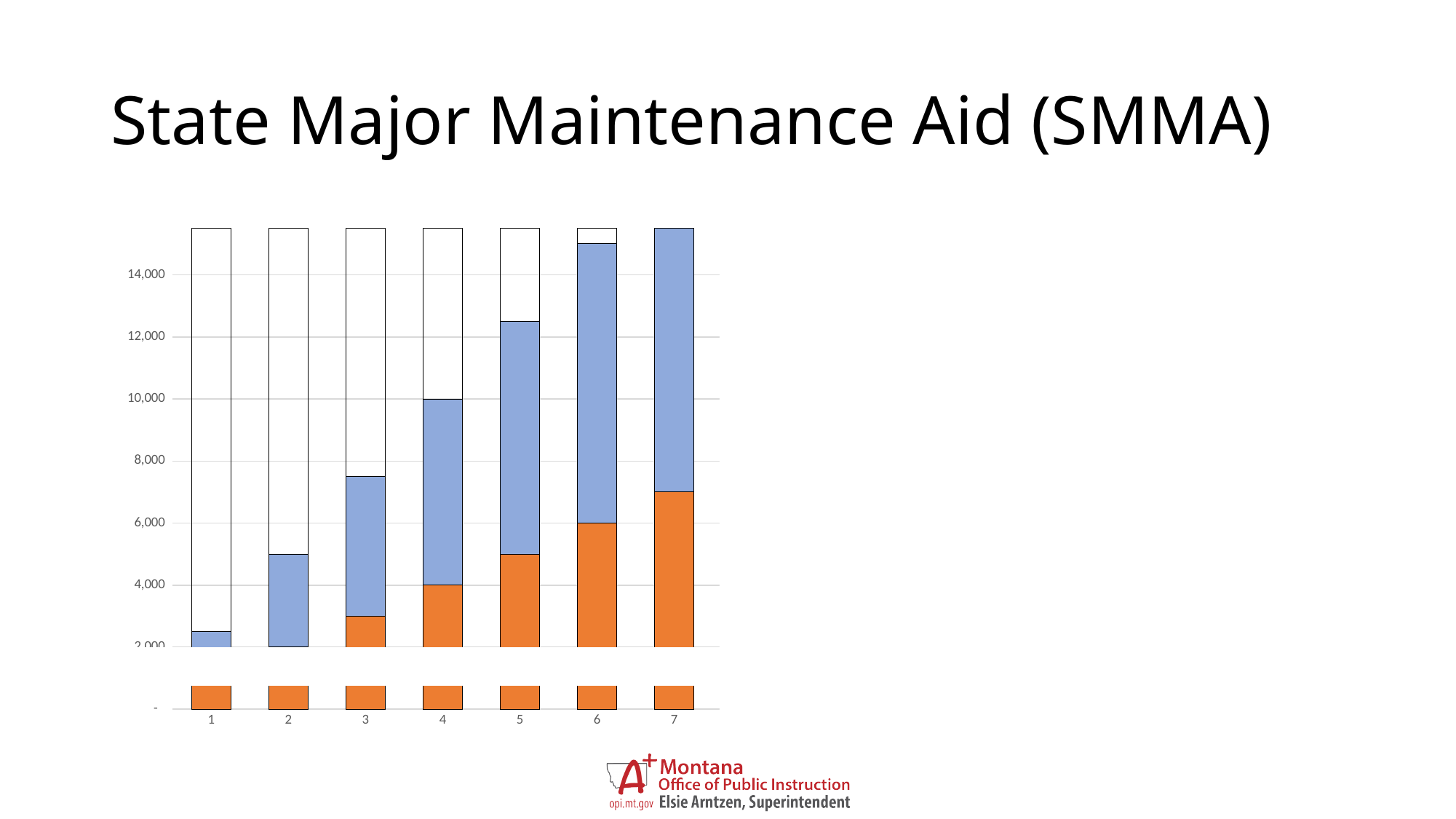
Is the top of the orange segment for category 7 greater or less than 6,000? greater What kind of chart is shown on the slide? Stacked bar chart Do the orange segments rise or fall as you move from category 1 to category 7? Rise Is the top of the blue segment for category 5 greater or less than 12,000? greater What is the title of the slide containing the chart? State Major Maintenance Aid (SMMA) Which has the taller orange segment, category 3 or category 5? 5 Which category has the smallest combined orange-plus-blue height? 1 At what axis value does the top of the orange segment for category 6 land? 6,000 Which category has the tallest orange segment? 7 How many categories are shown along the x axis of the chart? 7 Is the top of the blue segment for category 3 greater or less than 8,000? less At what axis value does the top of the orange segment for category 4 land? 4,000